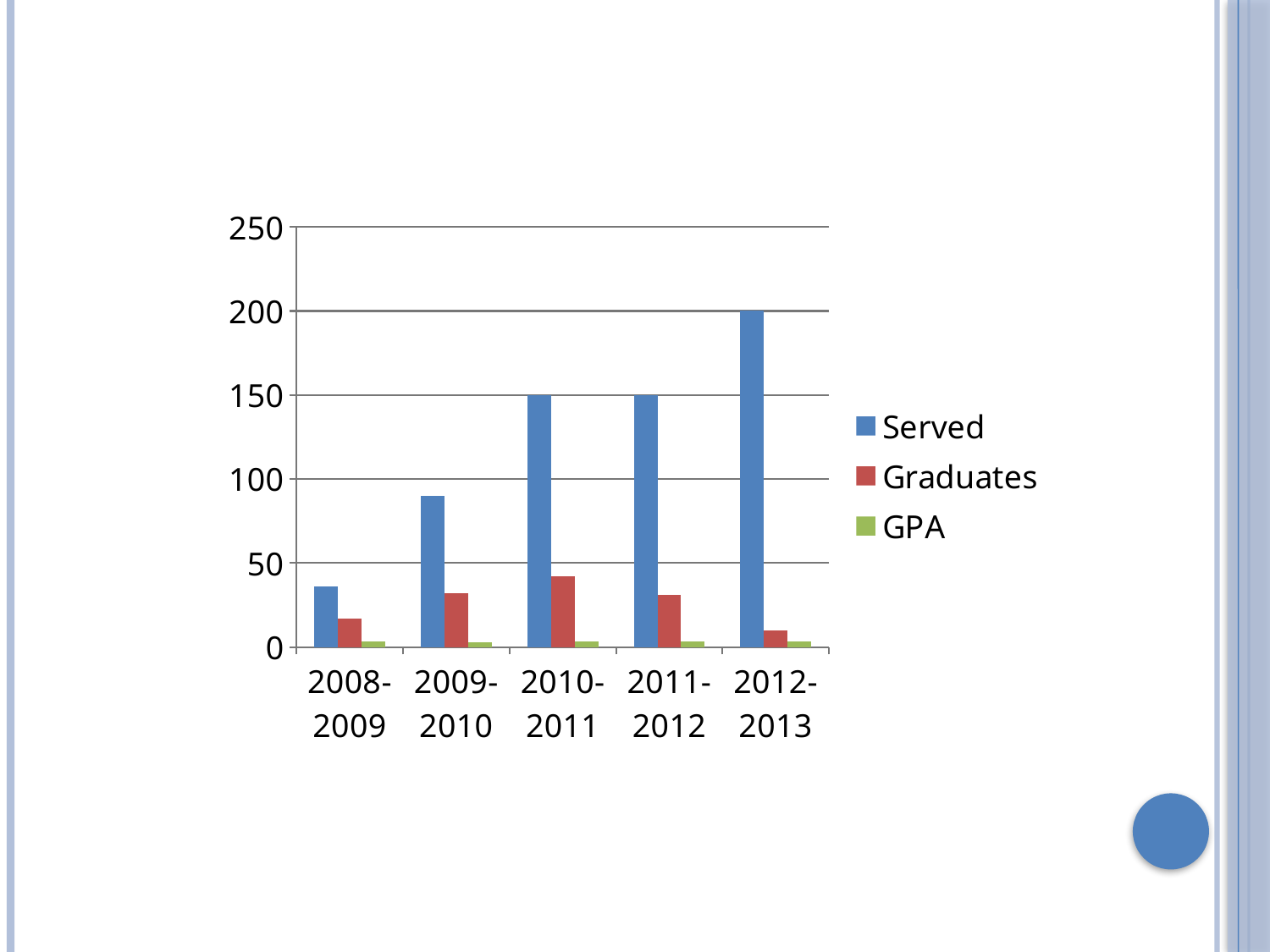
How many series does the legend list? 3 What is the difference between the Served values for 2012-2013 and 2010-2011? 50 How many academic-year categories are shown on the x axis? 5 Is the Graduates value for 2010-2011 greater or less than 50? less Which colour represents the GPA series in the legend? green What kind of chart is shown on the slide? bar chart Is the Served value for 2009-2010 greater or less than 100? less Which is larger: the Graduates value for 2010-2011 or for 2012-2013? 2010-2011 What is the Served value for 2010-2011? 150 Which year has the highest Served value? 2012-2013 What is the Served value for 2012-2013? 200 Which year has the lowest Served value? 2008-2009